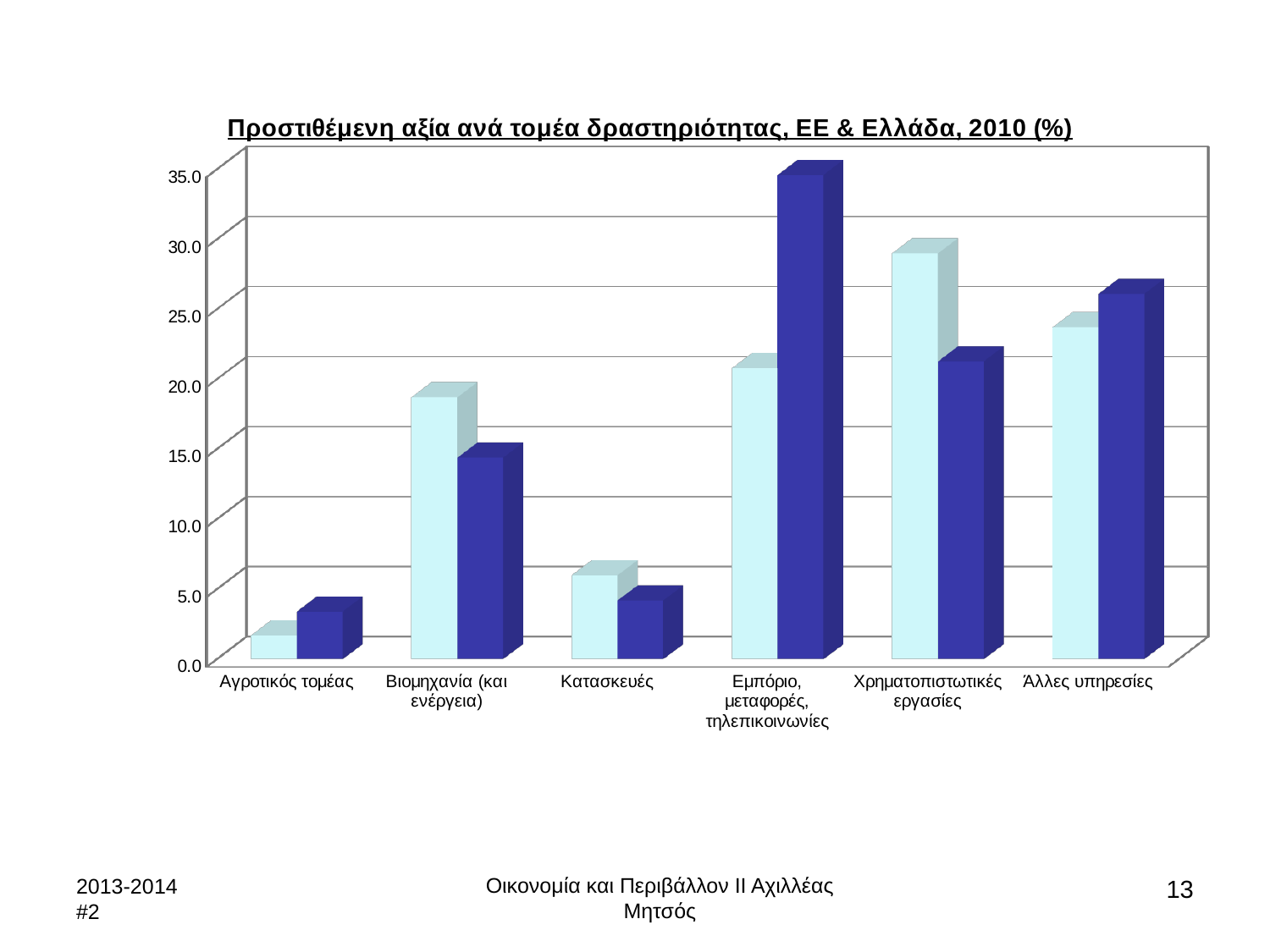
Which category has the tallest light blue bar? Χρηματοπιστωτικές εργασίες How many bars are plotted for each sector category? 2 Which category has the shortest light blue bar? Αγροτικός τομέας What kind of chart is shown on the slide? bar chart How many sector categories are shown on the x axis? 6 Is the light blue bar for Κατασκευές greater or less than 10.0? less What is the title of the chart? Προστιθέμενη αξία ανά τομέα δραστηριότητας, ΕΕ & Ελλάδα, 2010 (%) For Άλλες υπηρεσίες, which bar is taller, the light blue or the dark blue one? dark blue Is the dark blue bar for Εμπόριο, μεταφορές, τηλεπικοινωνίες greater or less than 30.0? greater Which category has the tallest dark blue bar? Εμπόριο, μεταφορές, τηλεπικοινωνίες Which category has the shortest dark blue bar? Αγροτικός τομέας For Βιομηχανία (και ενέργεια), which bar is taller, the light blue or the dark blue one? light blue